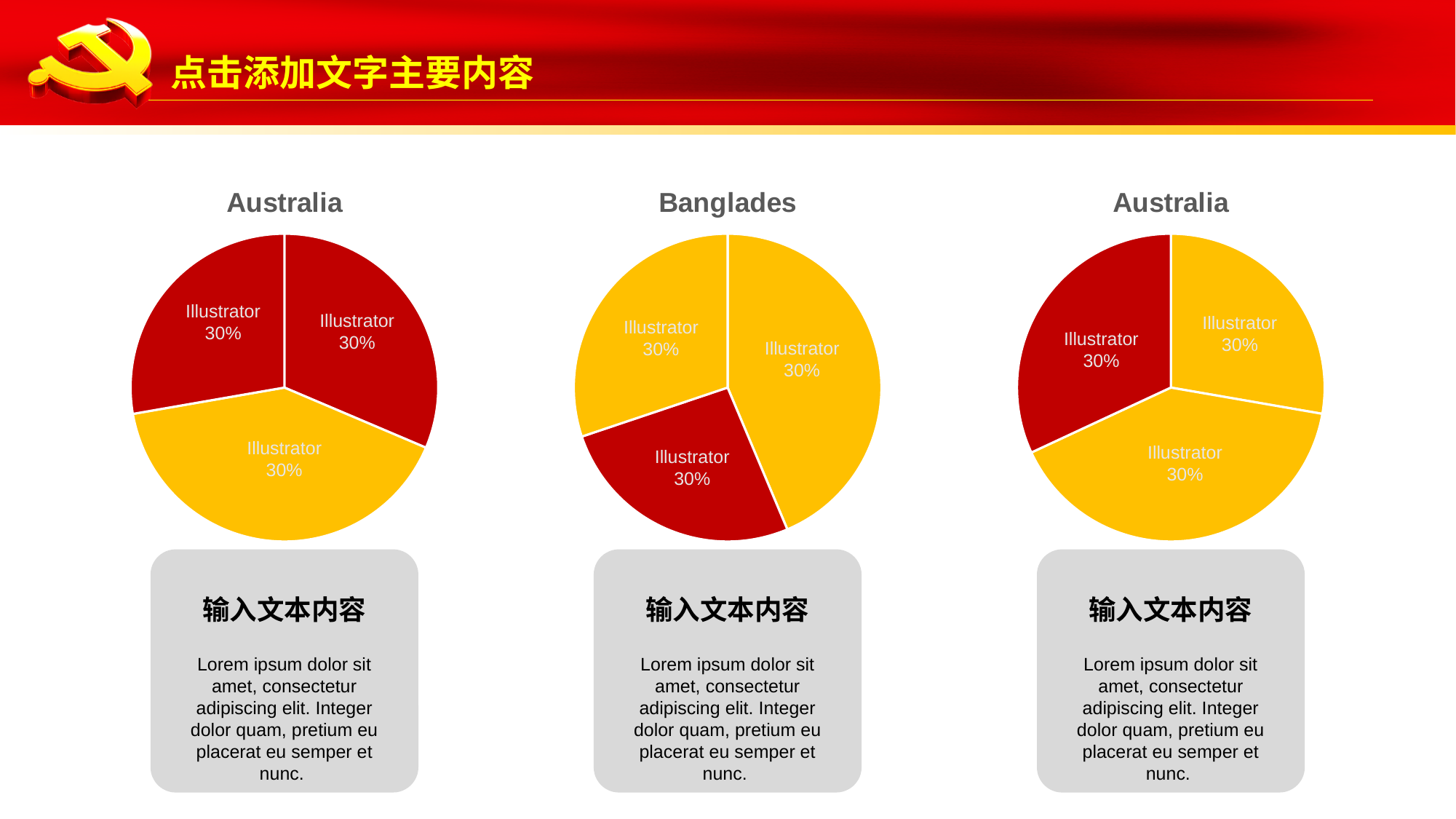
In the right chart titled Australia, what percentage is shown on the red slice? 30% What kind of chart is the right chart titled Australia? pie chart What label appears on every slice of the middle chart titled Banglades? Illustrator In the middle chart titled Banglades, what percentage is shown on the red slice? 30% What is the title of the middle chart? Banglades How many slices does the middle chart titled Banglades have? 3 In the left chart titled Australia, how many slices are red? 2 What kind of chart is the left chart titled Australia? pie chart In the left chart titled Australia, what percentage is shown on the yellow slice? 30% How many pie charts are on the slide? 3 How many slices does the right chart titled Australia have? 3